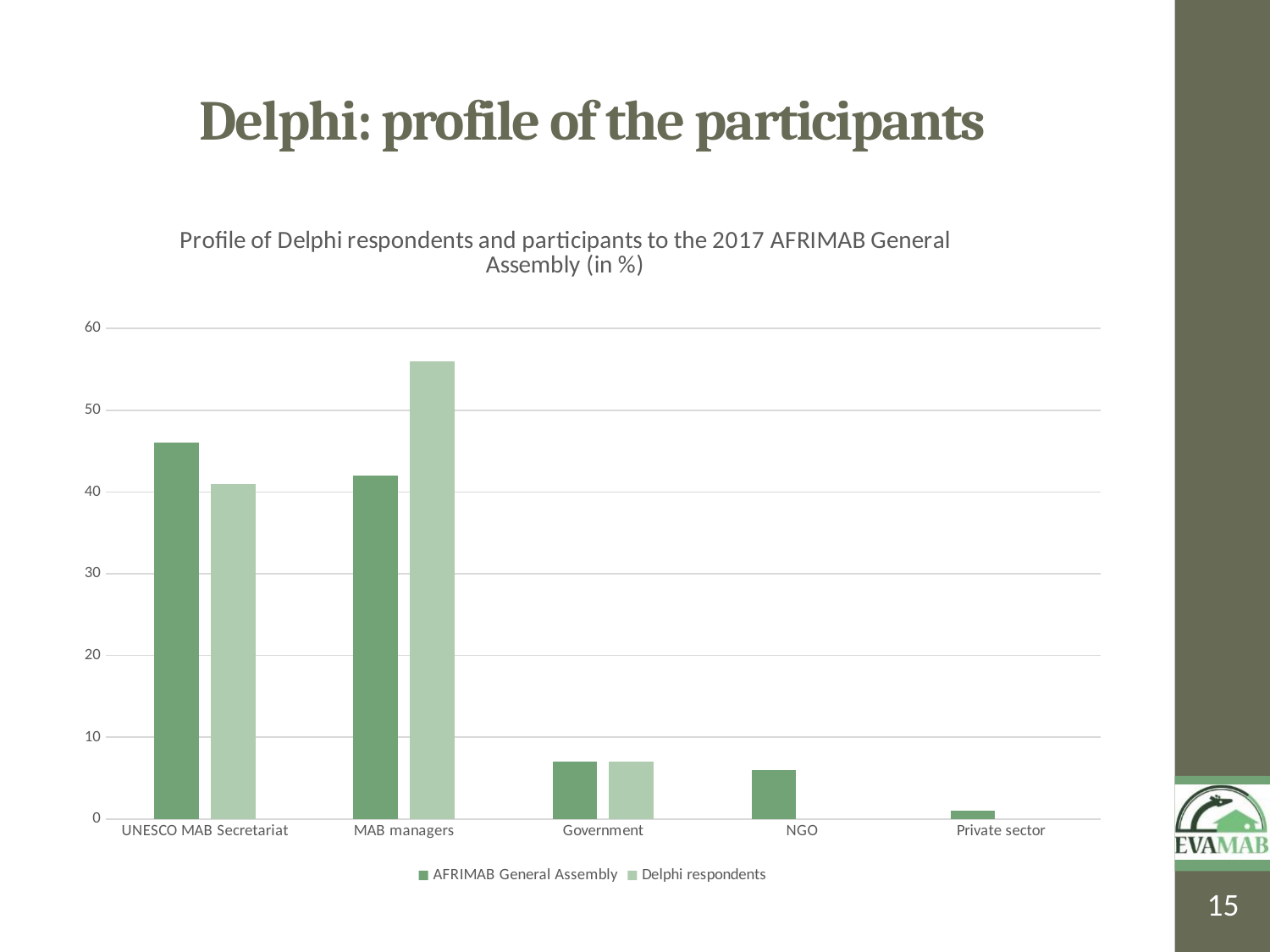
What kind of chart is shown on the slide? Bar chart Is the Delphi respondents value for MAB managers greater or less than 50? greater Is the AFRIMAB General Assembly value for Government greater or less than 10? less What is the title of the chart? Profile of Delphi respondents and participants to the 2017 AFRIMAB General Assembly (in %) How many series does the chart's legend list? 2 For UNESCO MAB Secretariat, which series has the larger value: AFRIMAB General Assembly or Delphi respondents? AFRIMAB General Assembly Which category has the lowest value for the AFRIMAB General Assembly series? Private sector For MAB managers, which series has the larger value: AFRIMAB General Assembly or Delphi respondents? Delphi respondents Is the AFRIMAB General Assembly value for UNESCO MAB Secretariat greater or less than 50? less Which category has the highest value for the Delphi respondents series? MAB managers How many categories are shown on the x axis of the chart? 5 Which series is shown in the lighter green colour in the chart? Delphi respondents